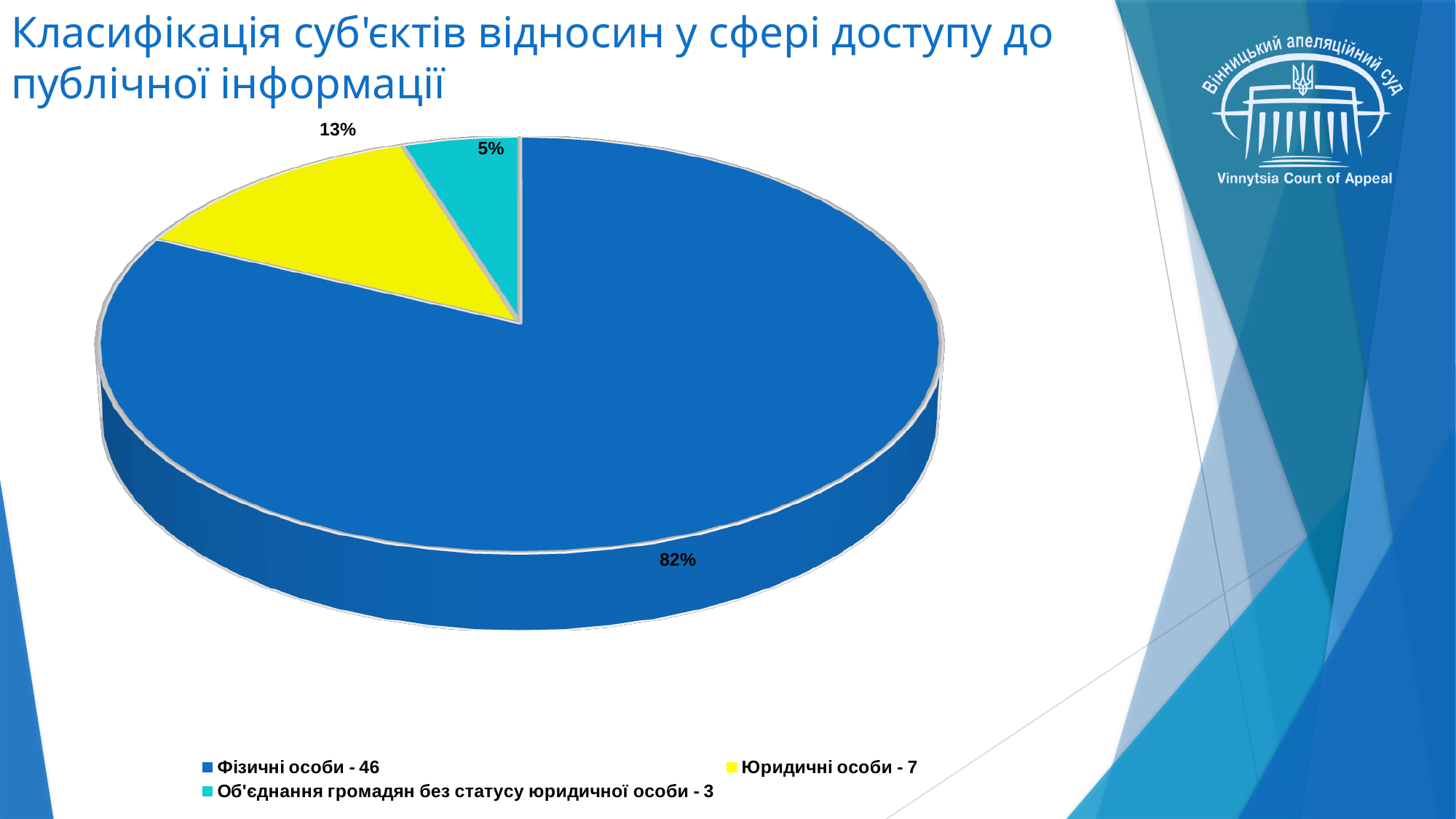
Which category has the largest slice of the pie? Фізичні особи - 46 What percentage share does the slice for "Фізичні особи - 46" have? 82% What kind of chart is shown on the slide? Pie chart What percentage share does the slice for "Юридичні особи - 7" have? 13% How many entries does the legend list? 3 How many categories are shown in the pie chart? 3 Which slice is larger: "Юридичні особи - 7" or "Об'єднання громадян без статусу юридичної особи - 3"? Юридичні особи - 7 Which category has the smallest slice of the pie? Об'єднання громадян без статусу юридичної особи - 3 What is the difference in percentage points between the "Фізичні особи - 46" slice and the "Юридичні особи - 7" slice? 69 What is the title of the slide containing the pie chart? Класифікація суб'єктів відносин у сфері доступу до публічної інформації What percentage share does the slice for "Об'єднання громадян без статусу юридичної особи - 3" have? 5% What colour is the slice for "Юридичні особи - 7"? Yellow